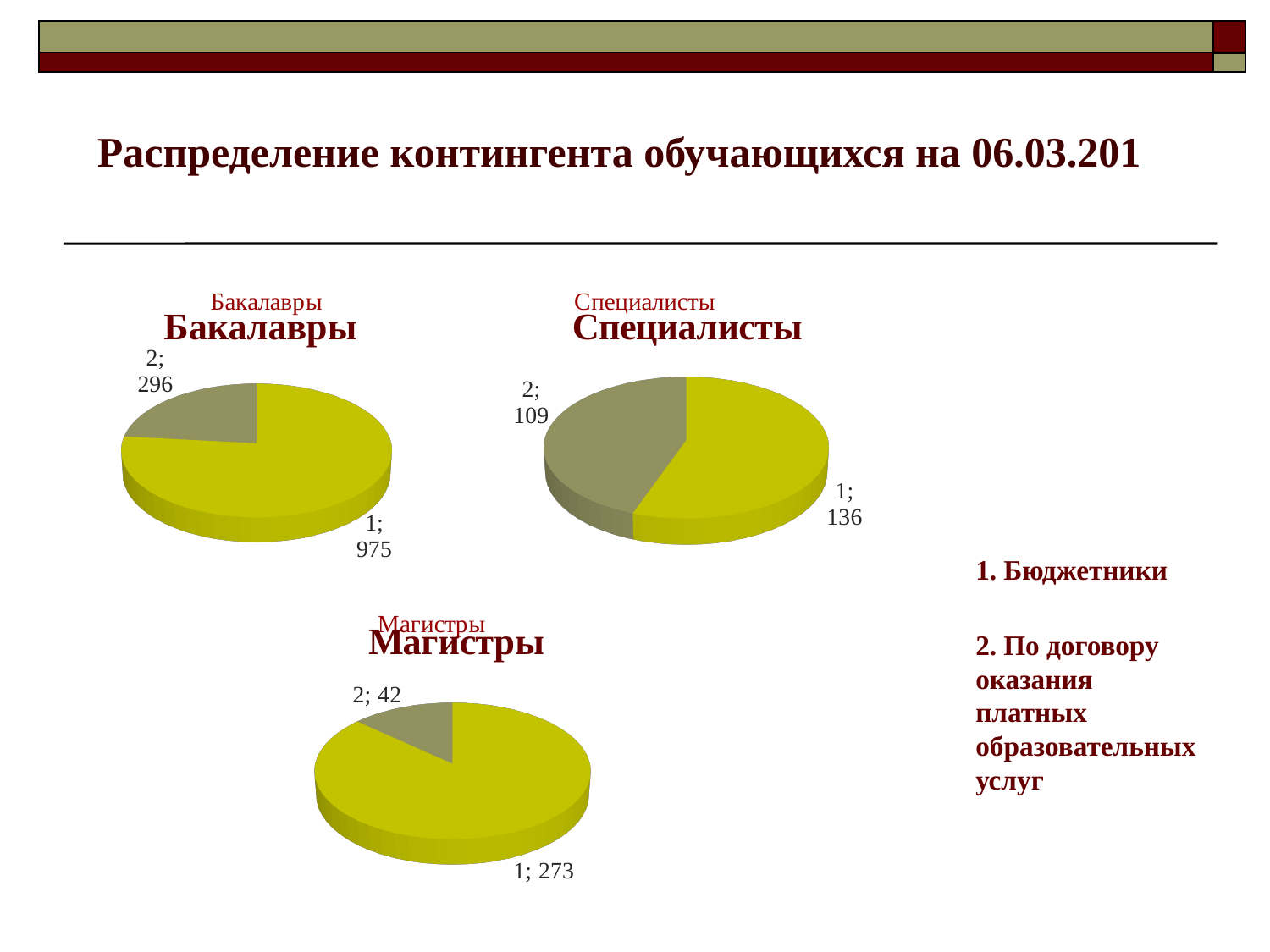
In the Магистры pie chart, what is the value for category 2? 42 How many pie charts are on the slide? 3 In the Специалисты pie chart, what is the value for category 2? 109 In the Магистры pie chart, what is the total of the two categories? 315 According to the legend text on the slide, what does category 1 stand for? Бюджетники What kind of chart is used for Бакалавры, Специалисты and Магистры? Pie chart In the Специалисты pie chart, which category is larger, 1 or 2? 1 In the Магистры pie chart, what is the value for category 1? 273 In the Специалисты pie chart, what is the value for category 1? 136 In the Бакалавры pie chart, what is the difference between category 1 and category 2? 679 In the Бакалавры pie chart, what is the value for category 1? 975 In the Бакалавры pie chart, what is the value for category 2? 296